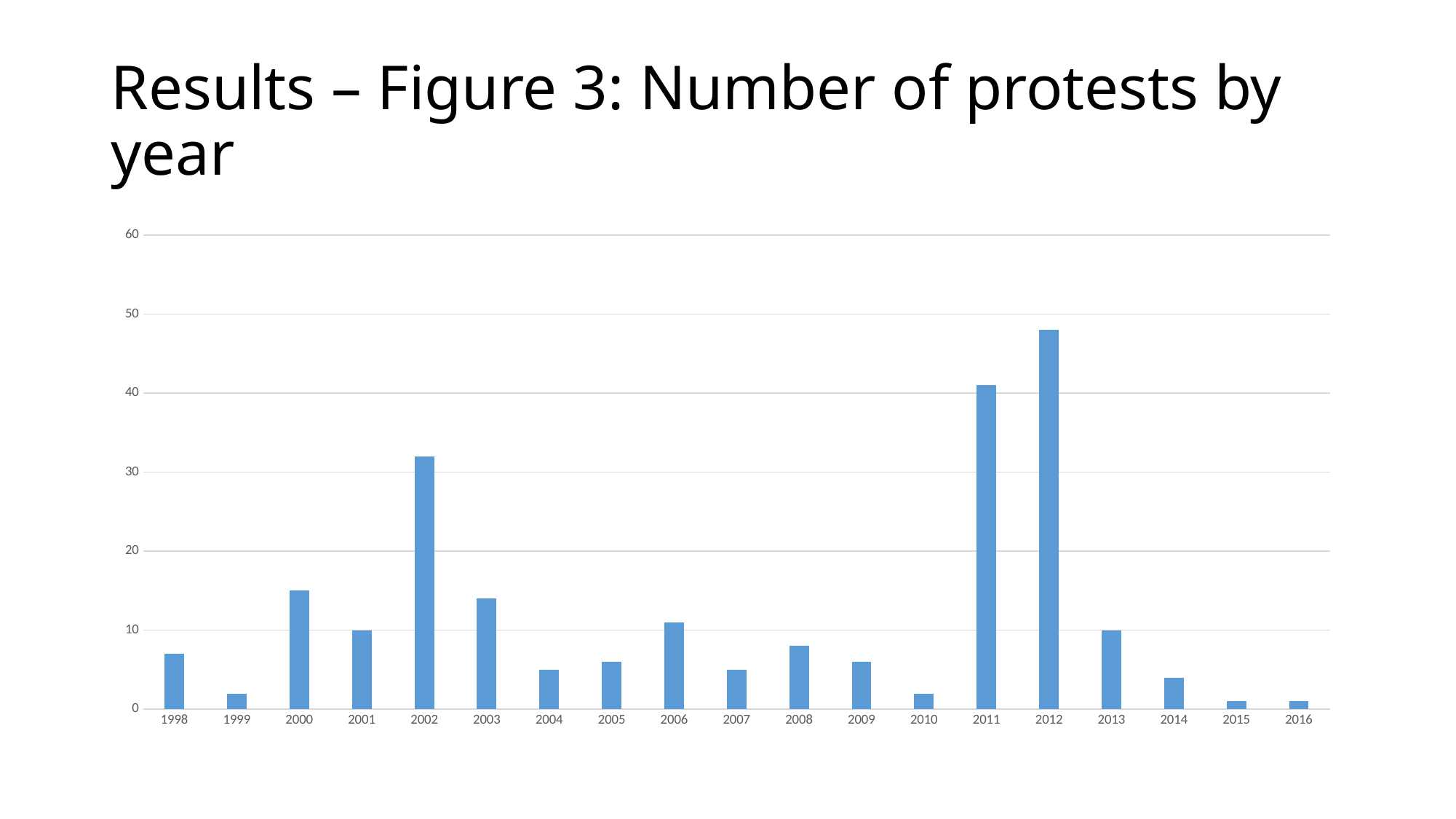
Is the number of protests in 2000 greater or less than 10? greater What kind of chart is shown on the slide? bar chart Do the number of protests rise or fall from 2012 to 2016? fall Which year has the highest number of protests? 2012 Is the number of protests in 2002 greater or less than 40? less What is the title of the slide containing the chart? Results – Figure 3: Number of protests by year Is the number of protests in 2012 greater or less than 40? greater Which year had more protests, 2002 or 2011? 2011 Which year had more protests, 1998 or 1999? 1998 How many years are shown on the x axis of the chart? 19